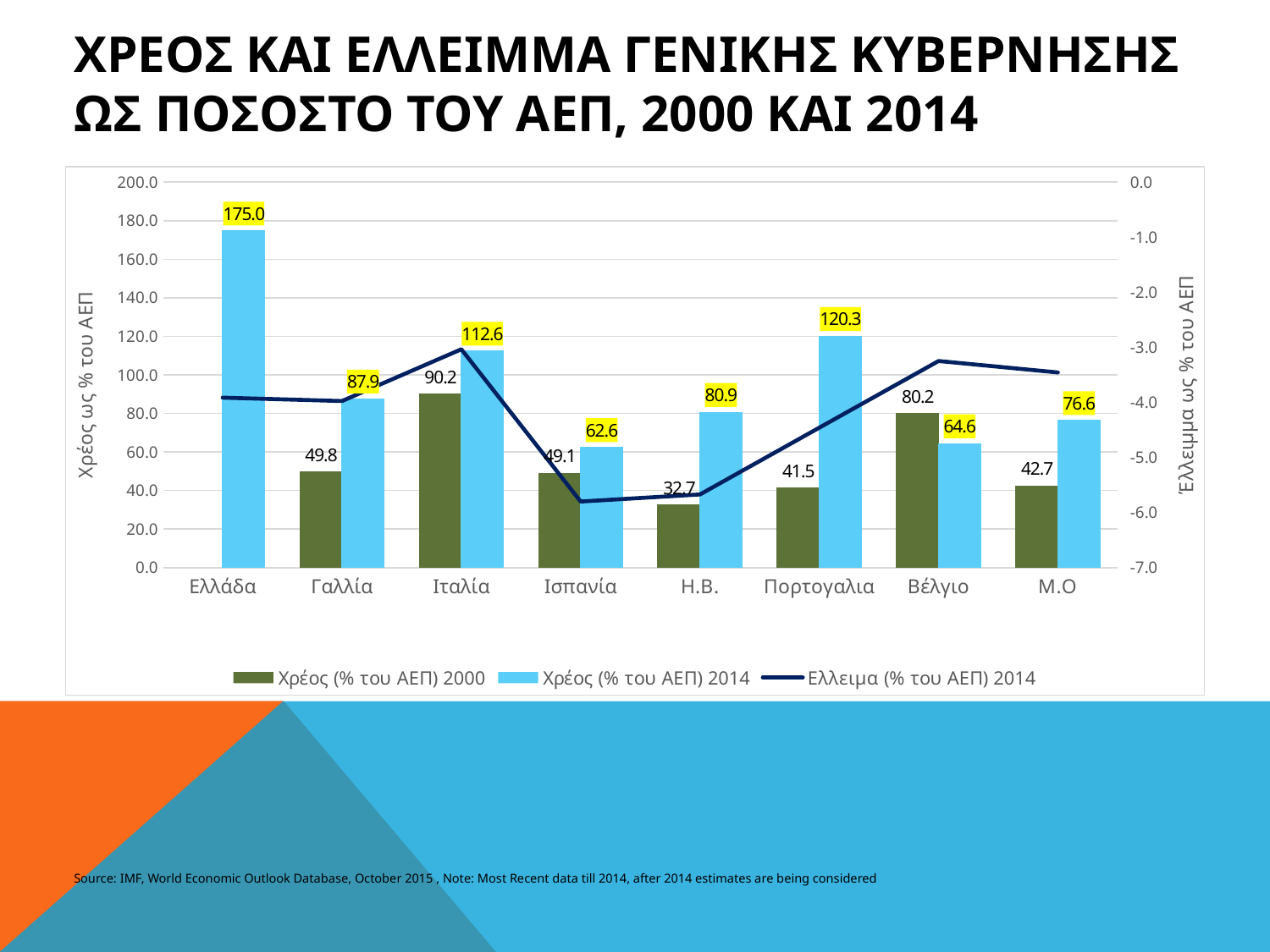
Which category has the lowest value for Χρέος (% του ΑΕΠ) 2000 among those with a labelled 2000 bar? Η.Β. What is the difference between the Χρέος (% του ΑΕΠ) 2014 and Χρέος (% του ΑΕΠ) 2000 values for Γαλλία? 38.1 How many series does the legend list? 3 What is the label of the left vertical axis? Χρέος ως % του ΑΕΠ How many categories are shown on the x axis? 8 Which is larger: Χρέος (% του ΑΕΠ) 2014 for Ιταλία or for Πορτογαλια? Πορτογαλια Which category has the highest value for Χρέος (% του ΑΕΠ) 2014? Ελλάδα Is the Χρέος (% του ΑΕΠ) 2014 value for Βέλγιο greater or less than 80.0? less What is the value of Χρέος (% του ΑΕΠ) 2014 for Πορτογαλια? 120.3 What is the value of Χρέος (% του ΑΕΠ) 2000 for Η.Β.? 32.7 What is the value of Χρέος (% του ΑΕΠ) 2014 for Ελλάδα? 175.0 What is the value of Χρέος (% του ΑΕΠ) 2000 for Ιταλία? 90.2